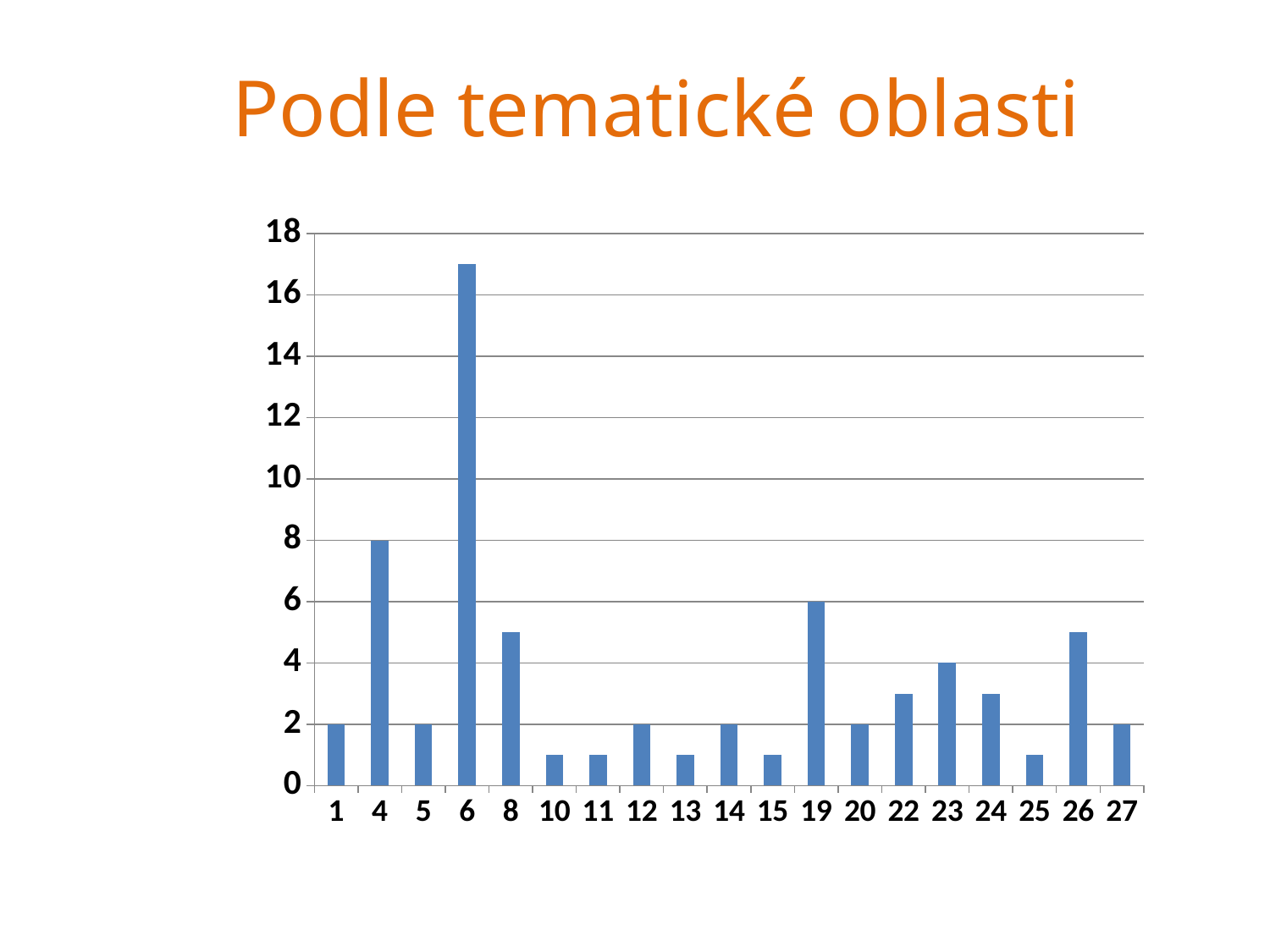
Which is larger, the value for category 4 or the value for category 19? category 4 What is the value for category 1? 2 What is the value for category 23? 4 What type of chart is shown on the slide? bar chart Which category has the highest bar? 6 What is the value for category 4? 8 Is the value for category 10 greater or less than 2? less Is the value for category 6 greater or less than 16? greater How many categories are shown on the x axis? 19 What is the title of the chart? Podle tematické oblasti What is the value for category 19? 6 What is the difference between the values for category 4 and category 1? 6